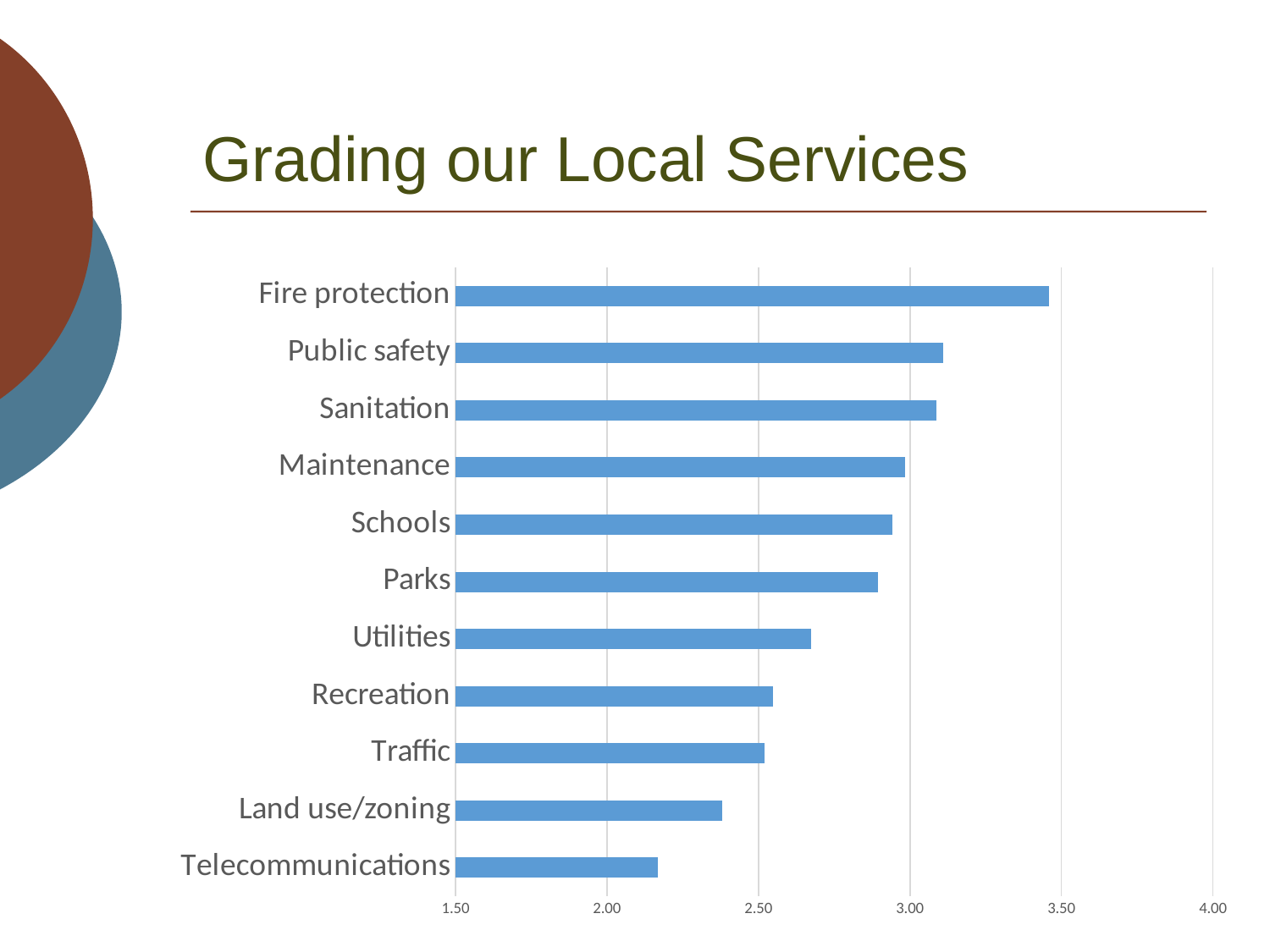
Which has the larger value, Utilities or Recreation? Utilities Is the value for Parks greater or less than 3.00? less Is the value for Fire protection greater or less than 3.00? greater Is the value for Land use/zoning greater or less than 2.50? less Which has the larger value, Land use/zoning or Schools? Schools Which service has the lowest value in the chart? Telecommunications What kind of chart is shown on the slide? Bar chart How many service categories are plotted in the chart? 11 Which service has the highest value in the chart? Fire protection What is the title of the slide containing the chart? Grading our Local Services